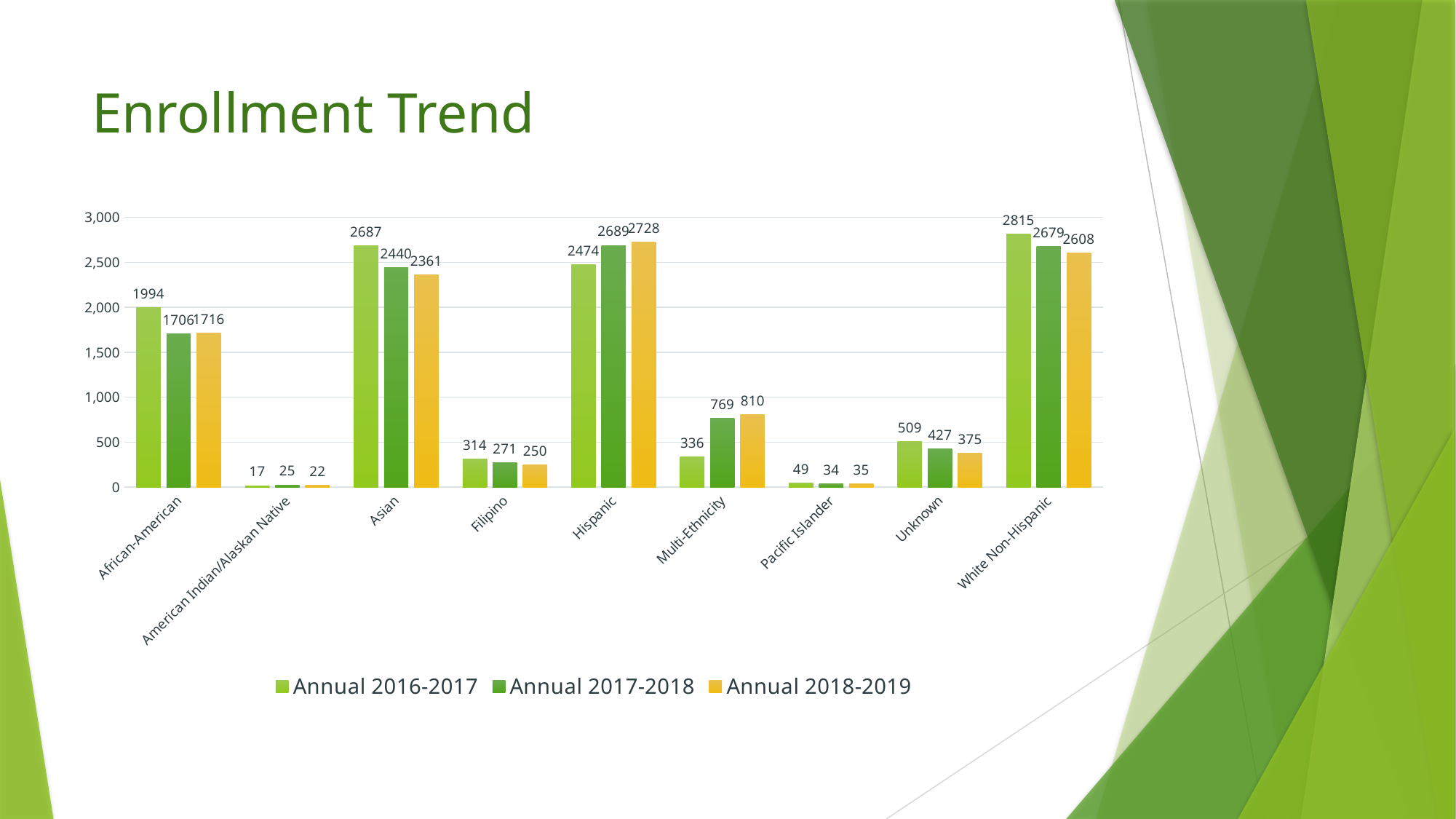
Which category has the highest Annual 2016-2017 value? White Non-Hispanic What is the title of the chart? Enrollment Trend What is the Annual 2016-2017 value for African-American? 1994 What is the Annual 2017-2018 value for Multi-Ethnicity? 769 Which is larger for Unknown: the Annual 2016-2017 value or the Annual 2018-2019 value? Annual 2016-2017 What kind of chart is shown on the slide? Bar chart What is the difference between the Annual 2016-2017 and Annual 2018-2019 values for Asian? 326 Which category has the lowest Annual 2018-2019 value? American Indian/Alaskan Native How many series does the legend list? 3 Do the values for Filipino rise or fall from Annual 2016-2017 to Annual 2018-2019? Fall How many categories are shown on the x axis? 9 What is the Annual 2018-2019 value for Hispanic? 2728